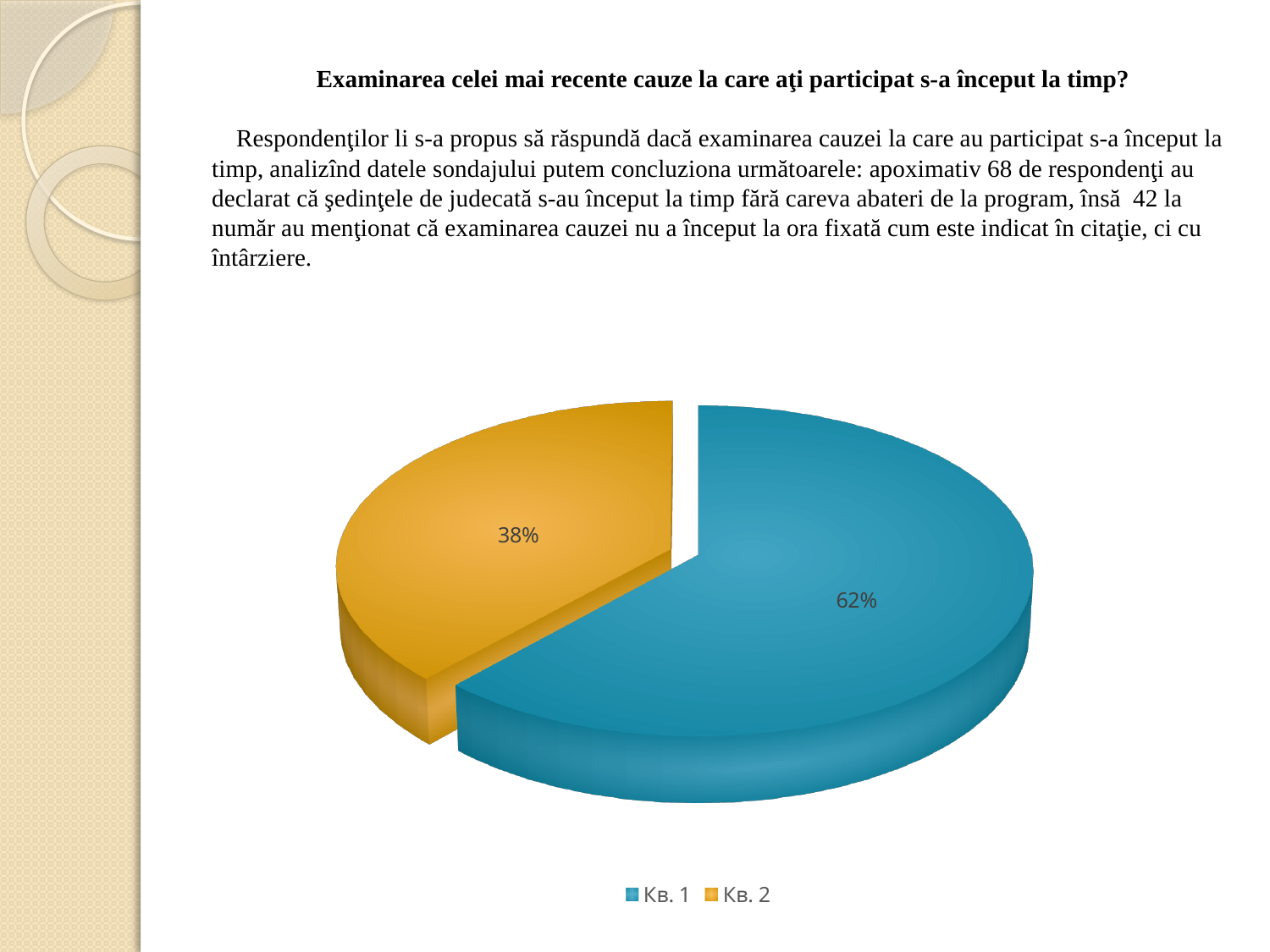
Which slice of the pie is the largest? Кв. 1 What colour is the Кв. 1 slice? blue Is the share of the Кв. 2 slice greater or less than 50%? less How many slices does the pie chart have? 2 How many entries does the legend list? 2 What percentage does the slice labelled Кв. 2 represent? 38% What colour is the Кв. 2 slice? orange Which slice is larger, Кв. 1 or Кв. 2? Кв. 1 What kind of chart is shown on the slide? pie chart What is the difference in percentage points between the Кв. 1 slice and the Кв. 2 slice? 24 What percentage does the slice labelled Кв. 1 represent? 62% Which slice of the pie is the smallest? Кв. 2